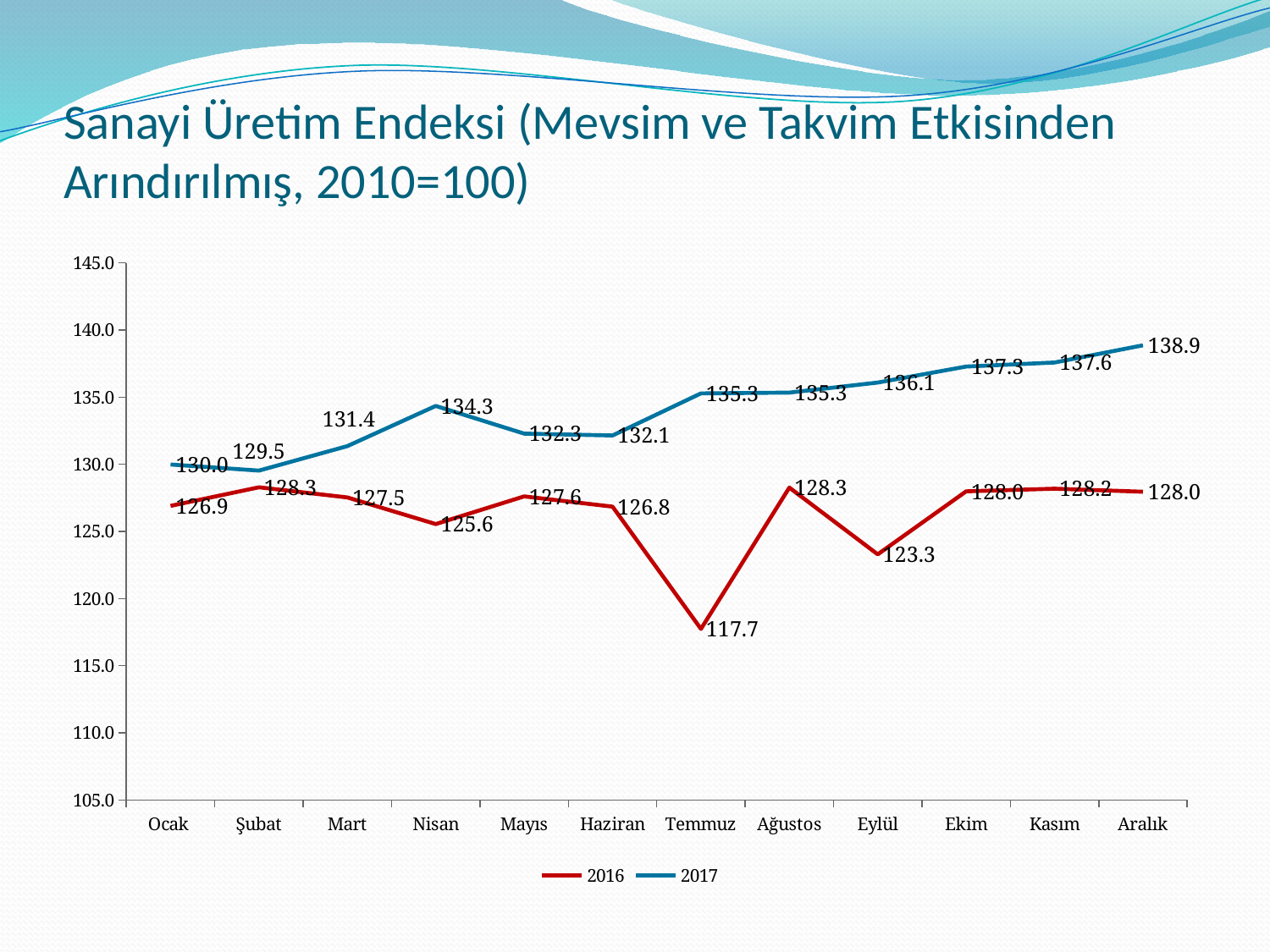
What is the value for 2016 in Temmuz? 117.7 How many months are shown on the x axis? 12 How many series does the legend list? 2 Which month has the lowest value for the 2016 series? Temmuz Does the 2017 series generally rise or fall from Ocak to Aralık? rise Which is larger in Eylül, the 2016 value or the 2017 value? 2017 Which series is drawn in red? 2016 What is the difference between the 2017 and 2016 values in Aralık? 10.9 What type of chart is shown on the slide? line chart What is the value for 2017 in Nisan? 134.3 What is the value for 2017 in Aralık? 138.9 Which month has the highest value for the 2017 series? Aralık